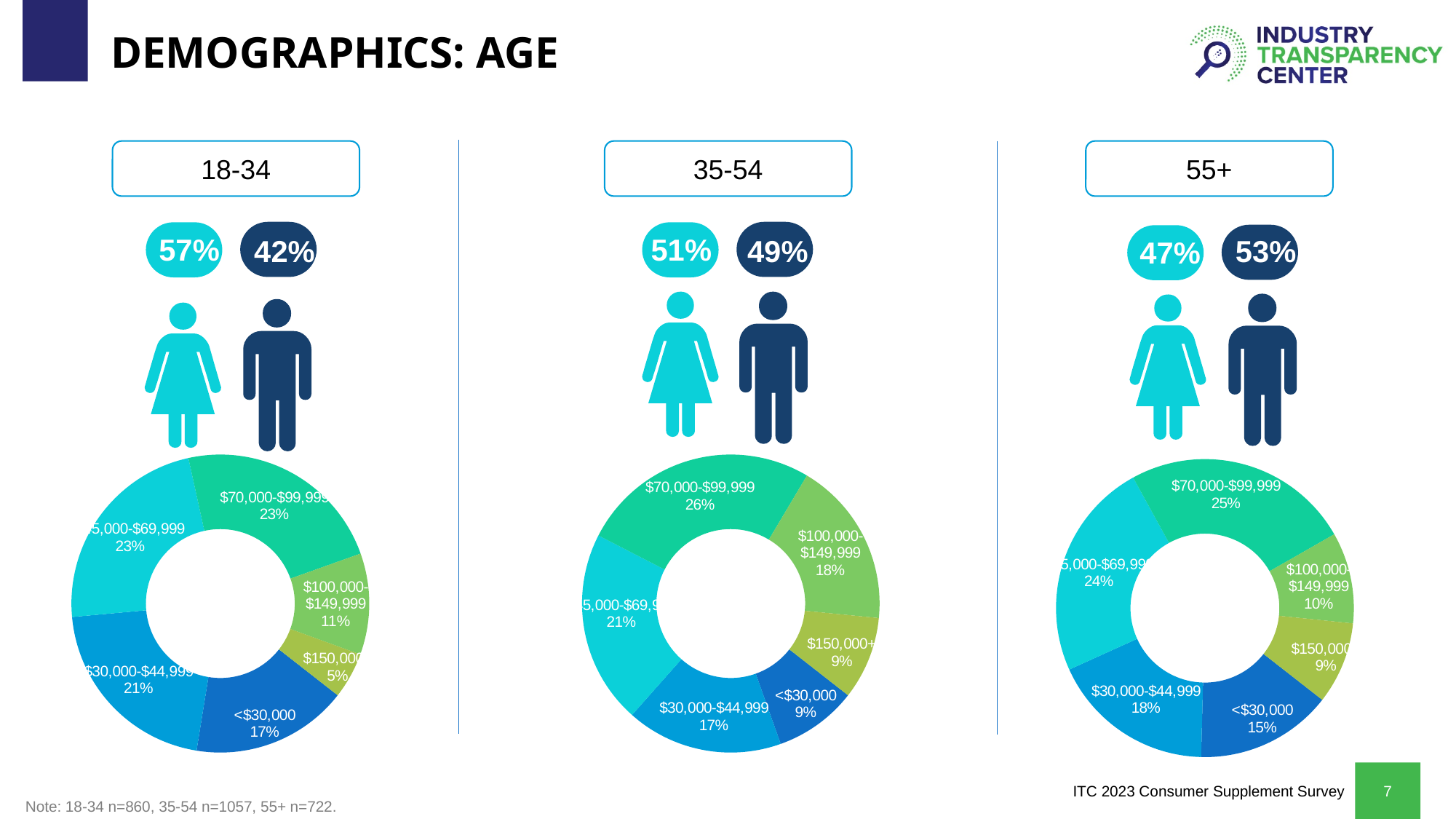
In the 18-34 donut chart, which income slice is the smallest? $150,000+ In the 35-54 donut chart, which income slice is the largest? $70,000-$99,999 Which age group's donut chart has the largest $150,000+ slice? 35-54 and 55+ (both 9%) What is the difference between the $70,000-$99,999 slice in the 35-54 chart and the same slice in the 18-34 chart? 3% In the 55+ donut chart, what share is the <$30,000 slice? 15% In the 18-34 donut chart, which is larger: the $30,000-$44,999 slice or the <$30,000 slice? $30,000-$44,999 How many income slices does the 35-54 donut chart have? 6 What type of chart is used to show income distribution for each age group? Donut (pie) chart In the 18-34 donut chart, what share is the $70,000-$99,999 slice? 23% In the 35-54 donut chart, what share is the $100,000-$149,999 slice? 18% How many donut charts are on the slide? 3 In the 55+ donut chart, what is the difference between the $30,000-$44,999 slice and the <$30,000 slice? 3%